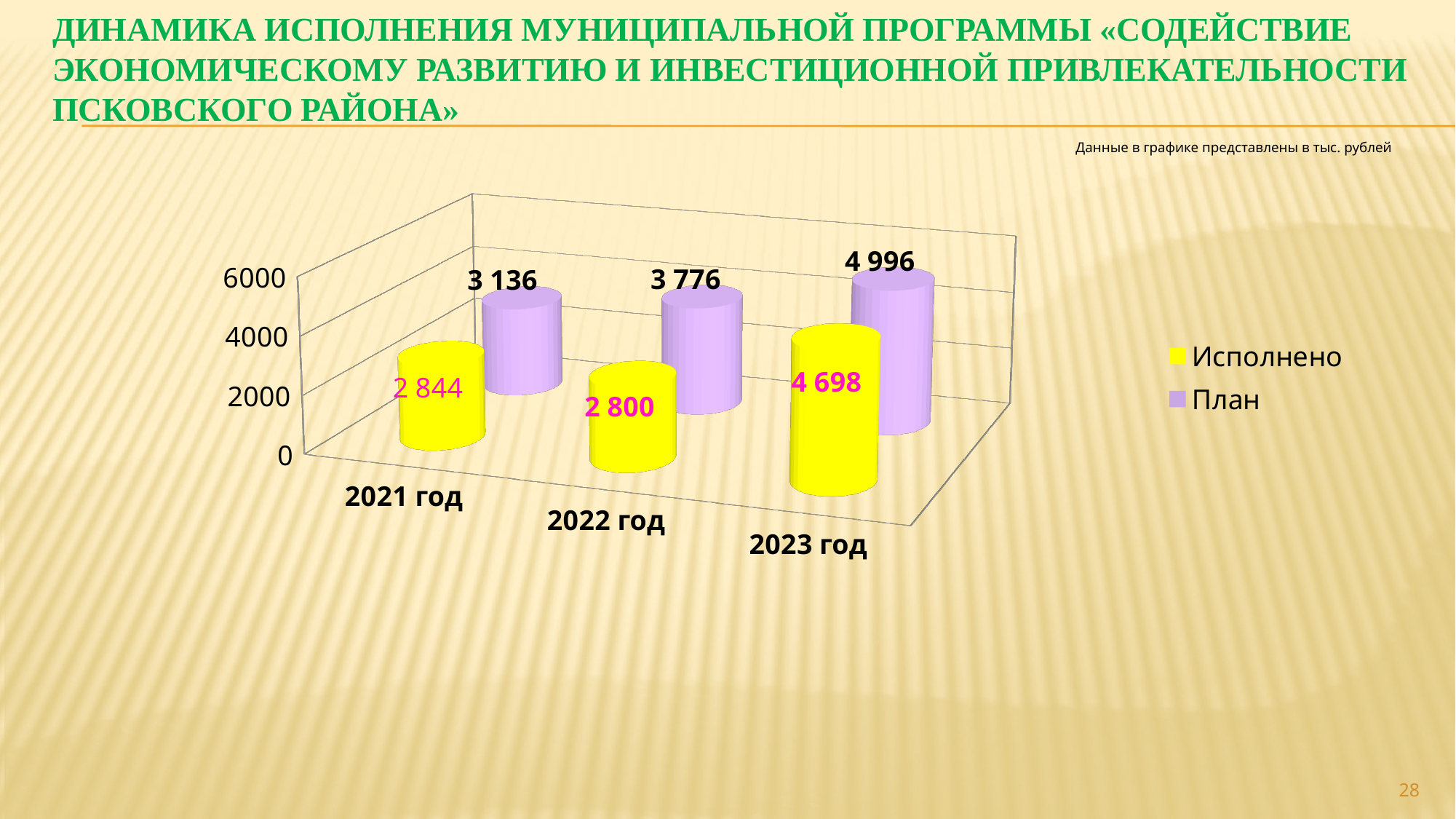
What is the difference between План and Исполнено for 2023 год? 298 What is the value of Исполнено for 2021 год? 2 844 What kind of chart is shown on the slide? bar chart What is the value of План for 2023 год? 4 996 How many series does the legend list? 2 Which is larger for 2021 год, План or Исполнено? План How many years are shown on the chart? 3 What is the difference between План and Исполнено for 2022 год? 976 In which year is the Исполнено value the lowest? 2022 год What is the value of План for 2022 год? 3 776 In which year is the Исполнено value the highest? 2023 год Is the Исполнено value for 2023 год greater or less than 4000? greater